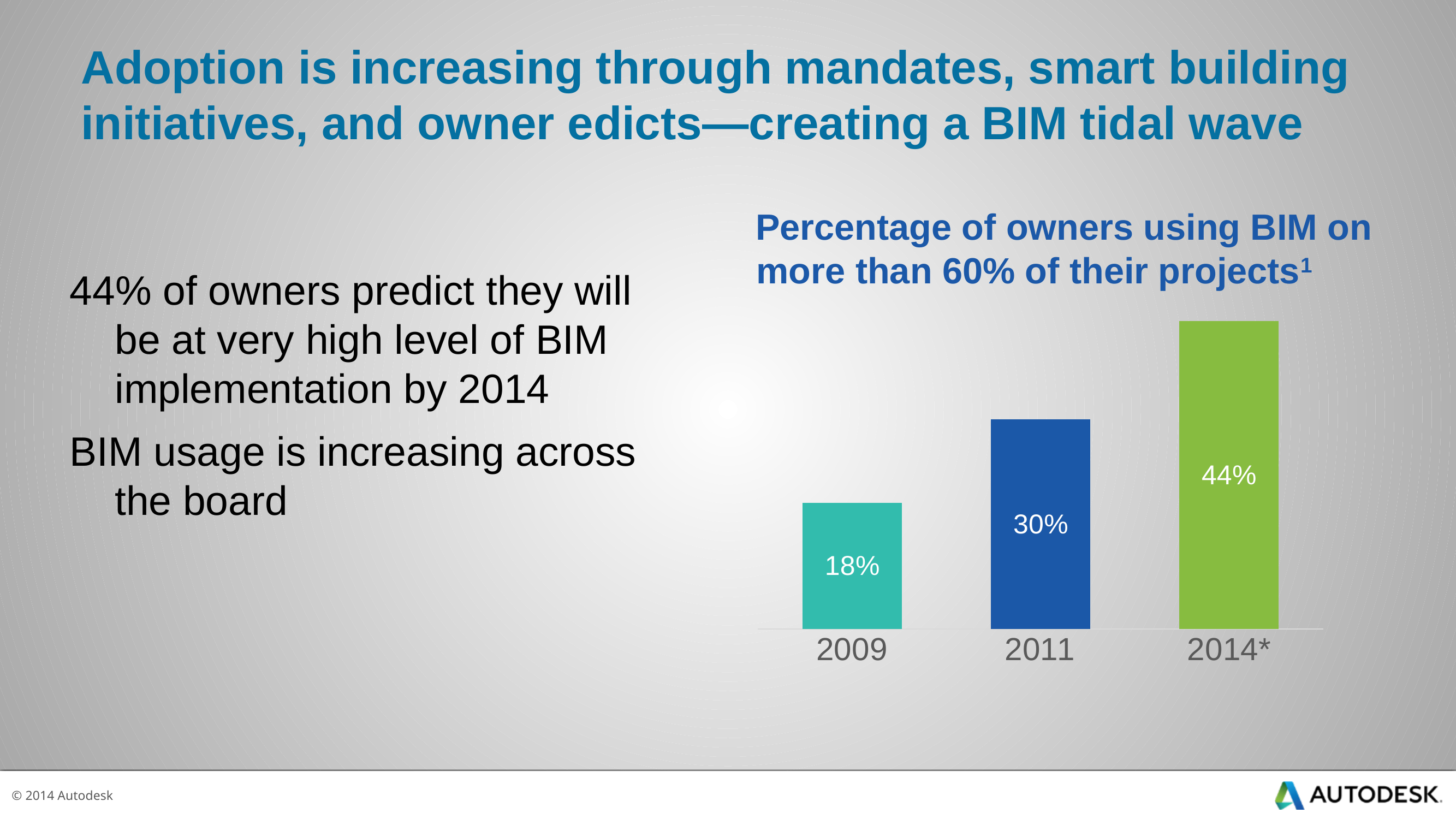
What is the value shown for 2011 in the chart? 30% What kind of chart is shown on the slide? Bar chart Do the values rise or fall from 2009 to 2014*? Rise Which year has the lowest value in the chart? 2009 How many years are shown on the x axis of the chart? 3 What percentage of owners used BIM on more than 60% of their projects in 2009? 18% What is the difference between the 2014* value and the 2009 value? 26% What is the title of the chart? Percentage of owners using BIM on more than 60% of their projects Which year has the highest percentage of owners using BIM on more than 60% of their projects? 2014* What is the value shown for 2014* in the chart? 44% Which is larger, the value for 2011 or the value for 2014*? 2014* What is the difference between the 2011 value and the 2009 value? 12%